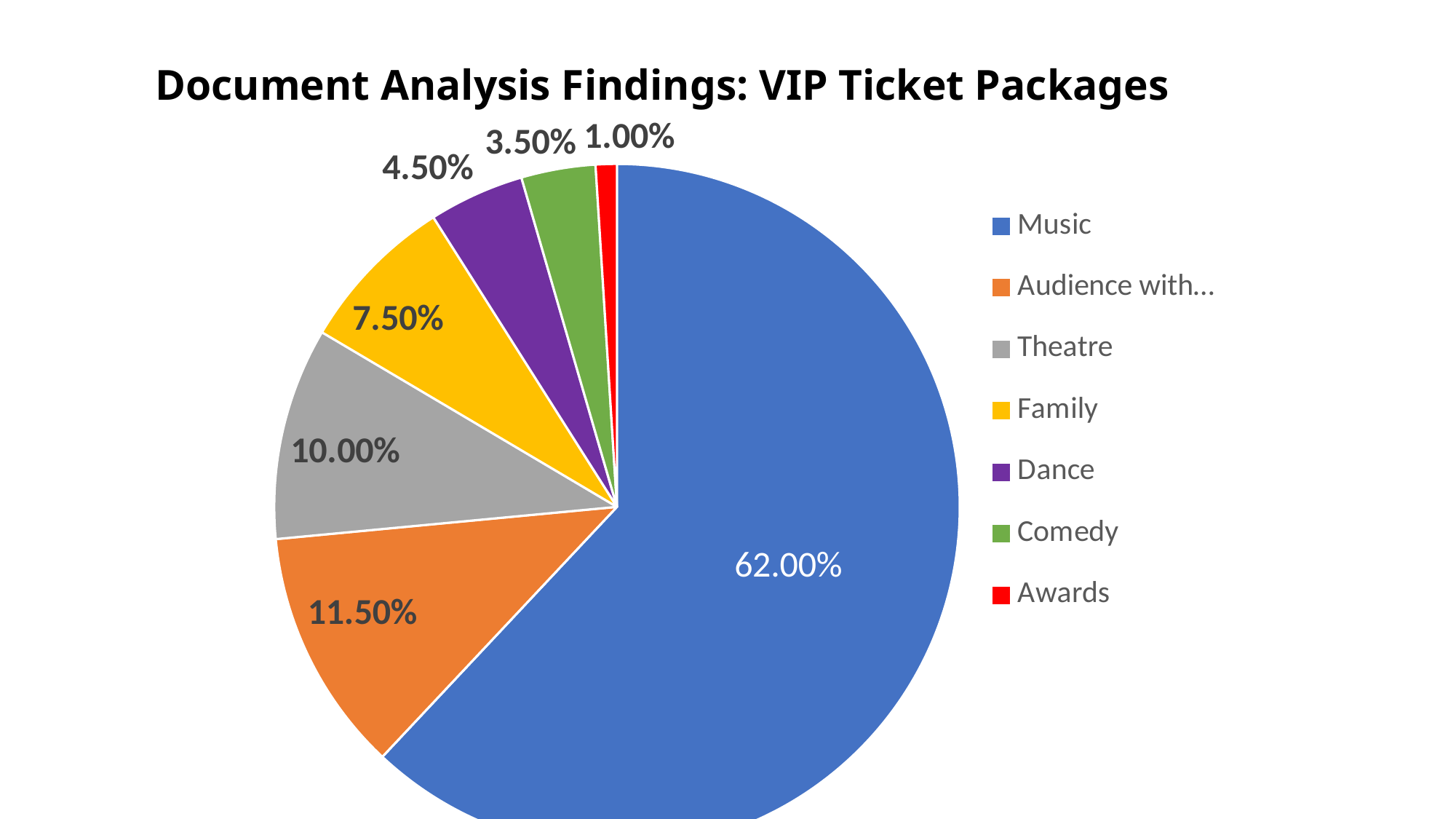
Which category has the largest slice? Music Which category has the smallest slice? Awards Which is larger, the value for Dance or the value for Comedy? Dance What is the value for Comedy? 3.50% What is the value for Dance? 4.50% How many categories does the legend list? 7 What type of chart is shown on the slide? pie chart What is the title of the chart? Document Analysis Findings: VIP Ticket Packages What is the value for Family? 7.50% What share of the pie does Music have? 62.00% What is the value for Theatre? 10.00% What is the difference between the Theatre and Family values? 2.50%